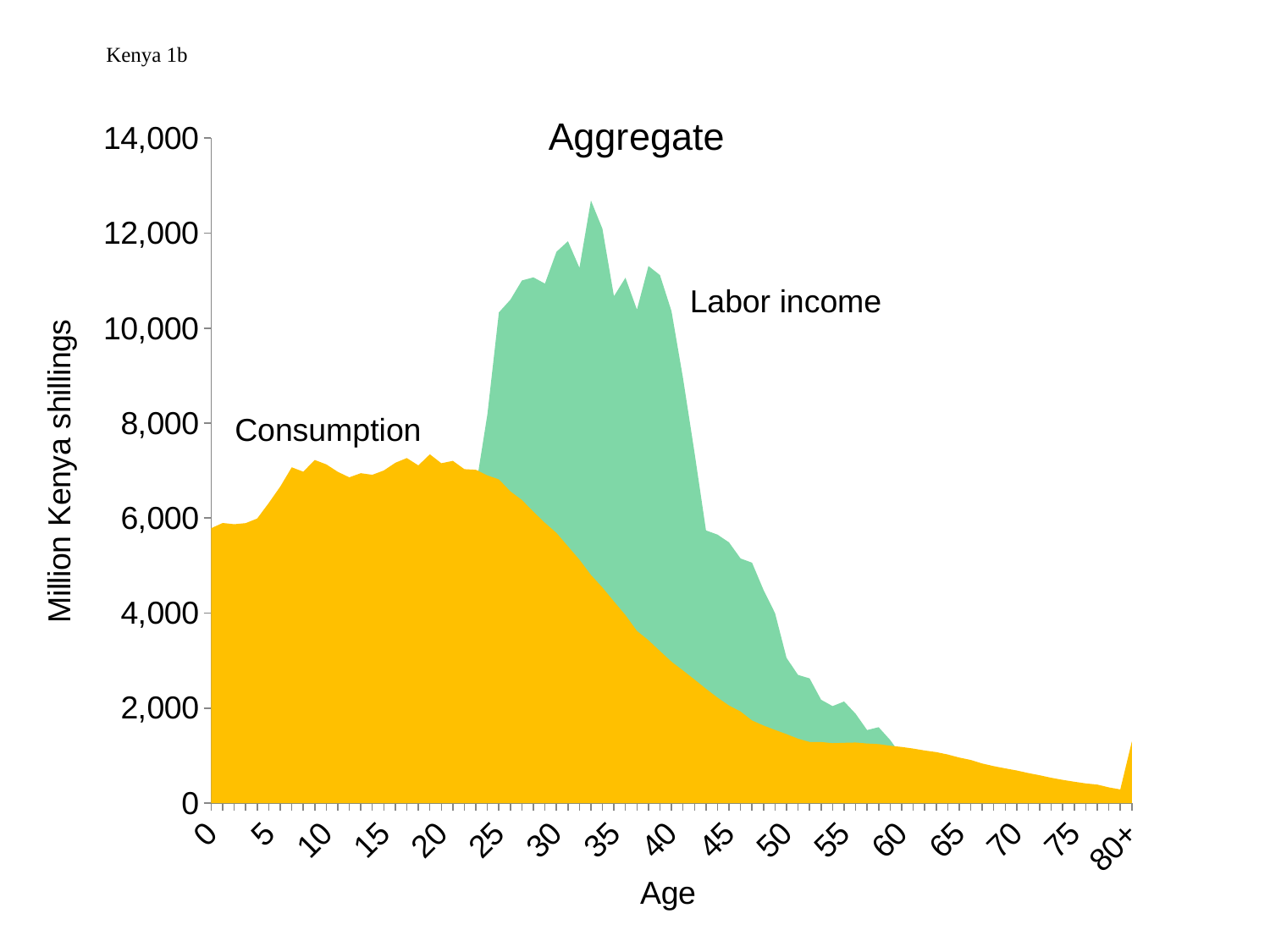
What kind of chart is shown on the slide? area chart Is the peak value of Consumption greater or less than 8,000? less Is the peak value of Labor income greater or less than 12,000? greater Is the value of Consumption at age 10 greater or less than 6,000? greater At age 35, which is larger, Labor income or Consumption? Labor income How many series are plotted on the chart? 2 What is the title of the chart? Aggregate What is the label on the vertical axis of the chart? Million Kenya shillings Does Consumption rise or fall between age 25 and age 60? fall